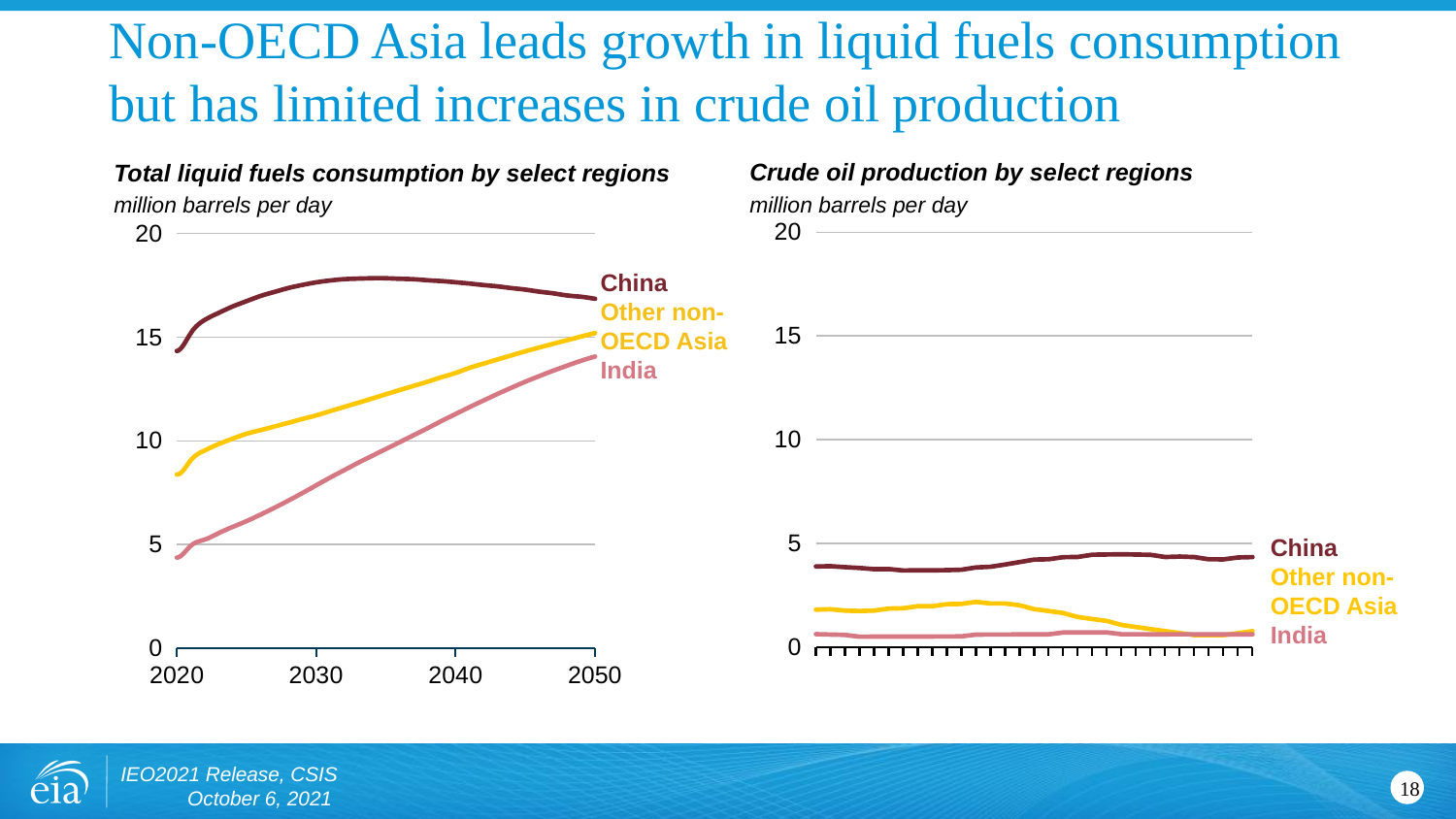
In the 'Crude oil production by select regions' chart, which region has the highest production? China In the 'Total liquid fuels consumption by select regions' chart, is the value for Other non-OECD Asia in 2020 greater or less than 10? less What kind of chart is the 'Total liquid fuels consumption by select regions' chart? line chart In the 'Total liquid fuels consumption by select regions' chart, is China's value in 2050 greater or less than 15? greater In the 'Total liquid fuels consumption by select regions' chart, is India's value in 2020 greater or less than 5? less What unit is used on the y axis of both charts? million barrels per day In the 'Crude oil production by select regions' chart, does production for Other non-OECD Asia rise or fall from 2020 to 2050? fall In the 'Total liquid fuels consumption by select regions' chart, does India's consumption rise or fall from 2020 to 2050? rise In the 'Total liquid fuels consumption by select regions' chart, which region has the highest consumption throughout the period? China How many series are shown in the 'Crude oil production by select regions' chart? 3 In the 'Total liquid fuels consumption by select regions' chart, which region has the lowest consumption in 2020? India